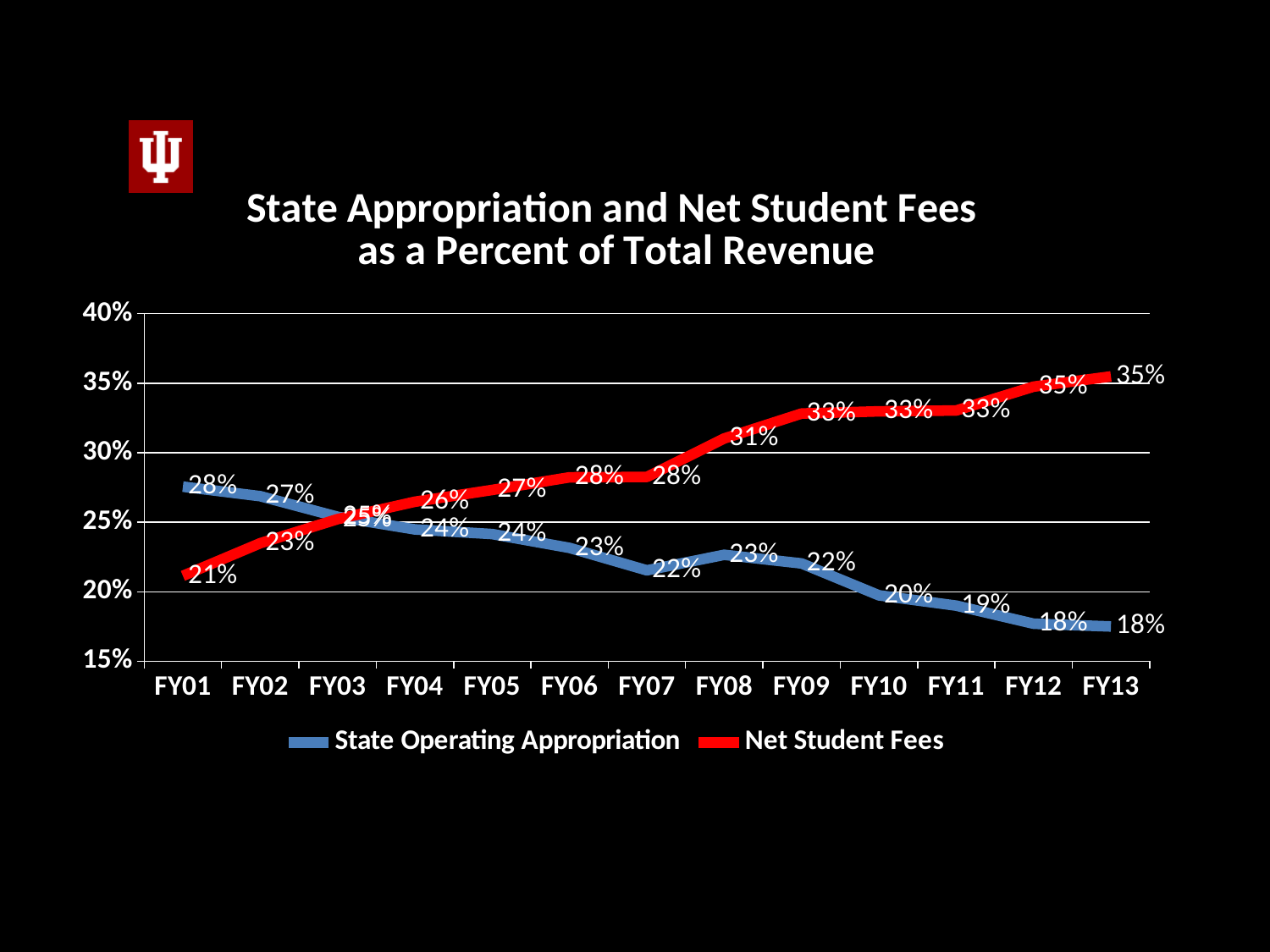
In which fiscal year is State Operating Appropriation at its highest? FY01 In which fiscal year is Net Student Fees at its lowest? FY01 Does the State Operating Appropriation line generally rise or fall from FY01 to FY13? Fall What type of chart is shown on the slide? Line chart What is the value for Net Student Fees in FY01? 21% How many series does the legend list? 2 How many fiscal years are plotted on the x axis? 13 What colour is the Net Student Fees line? Red What is the value for State Operating Appropriation in FY13? 18% What is the value for Net Student Fees in FY08? 31% Which is larger in FY02, State Operating Appropriation or Net Student Fees? State Operating Appropriation What is the difference between Net Student Fees and State Operating Appropriation in FY13? 17%